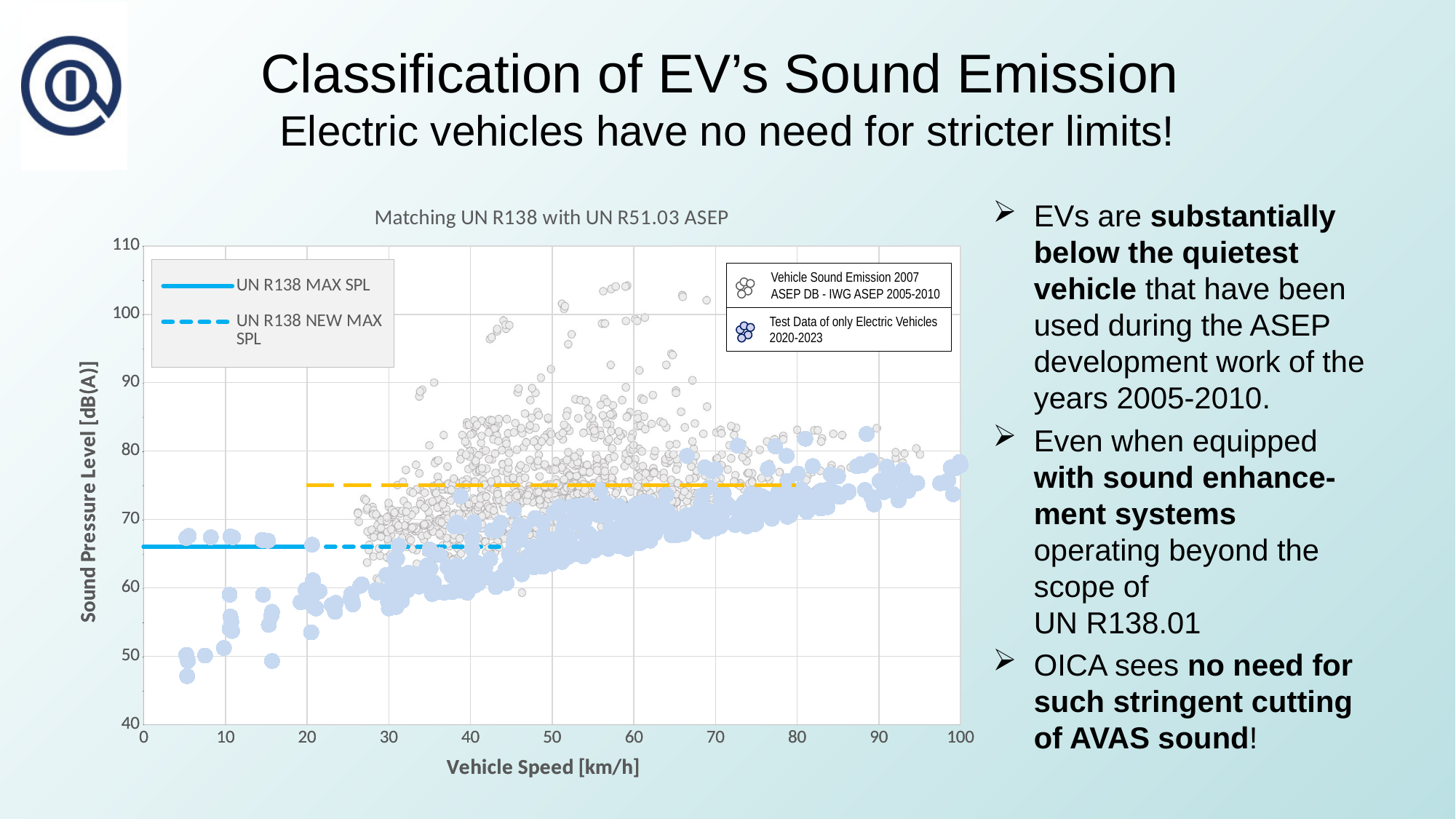
What is the label of the x axis of the chart? Vehicle Speed [km/h] Is the UN R138 MAX SPL line greater or less than 60 dB(A)? greater Is the UN R138 MAX SPL line greater or less than 70 dB(A)? less How many line entries does the legend in the upper left of the chart list? 2 What kind of chart is shown on the slide? scatter chart Which series generally has higher sound pressure levels at 50 km/h: Vehicle Sound Emission 2007 ASEP DB or Test Data of only Electric Vehicles 2020-2023? Vehicle Sound Emission 2007 ASEP DB What is the lowest tick value shown on the y axis of the chart? 40 Do the Test Data of only Electric Vehicles 2020-2023 values generally rise or fall as vehicle speed increases? rise What is the highest tick value shown on the y axis of the chart? 110 Is the yellow dashed line in the chart greater or less than 70 dB(A)? greater What is the highest tick value shown on the x axis of the chart? 100 What is the title of the chart? Matching UN R138 with UN R51.03 ASEP